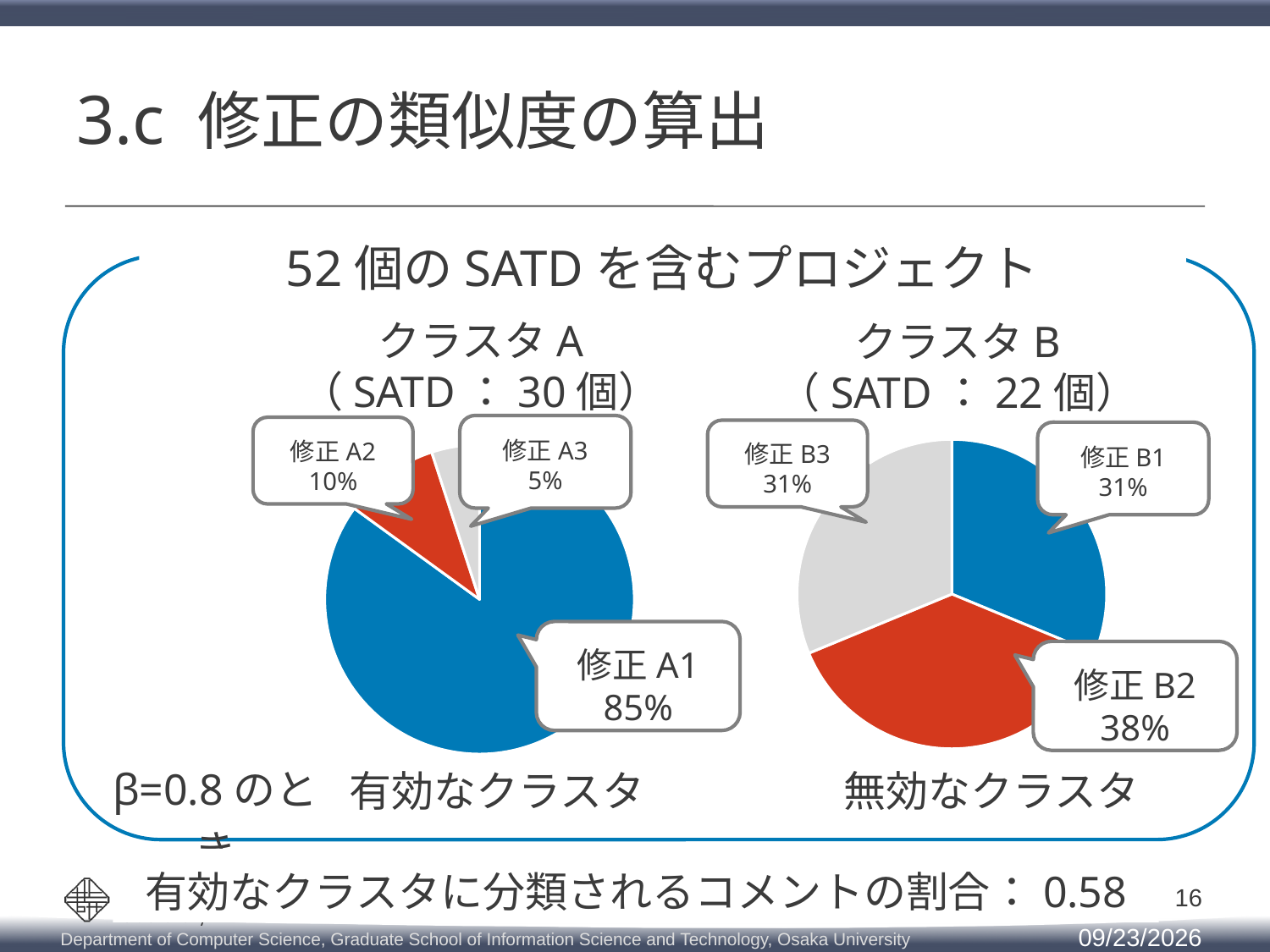
In the クラスタ A pie chart, which slice is the largest? 修正 A1 In the クラスタ A pie chart, what share does 修正 A3 have? 5% In the クラスタ A pie chart, what share does 修正 A1 have? 85% In the クラスタ B pie chart, which slice is the largest? 修正 B2 In the クラスタ A pie chart, which slice is the smallest? 修正 A3 In the クラスタ A pie chart, what share does 修正 A2 have? 10% What kind of chart is used for クラスタ A? pie chart In the クラスタ B pie chart, how many slices are there? 3 How many SATD does クラスタ B contain according to its chart title? 22 個 In the クラスタ A pie chart, what is the difference in percentage points between 修正 A1 and 修正 A2? 75